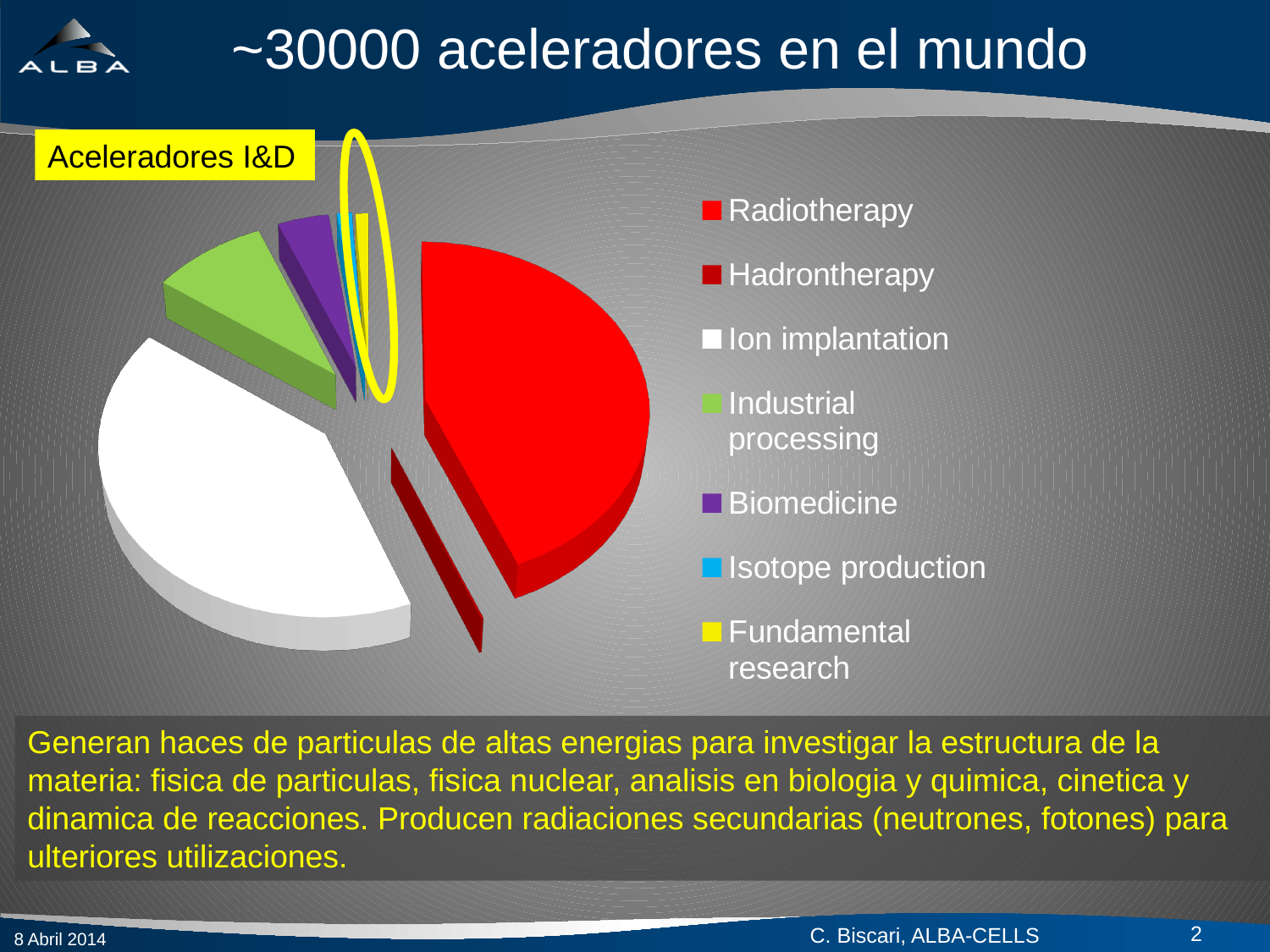
What colour is the Radiotherapy slice in the pie chart? red What kind of chart is shown on the slide? pie chart Which is larger in the pie chart, the slice for Radiotherapy or the slice for Hadrontherapy? Radiotherapy What is the title of the slide containing the pie chart? ~30000 aceleradores en el mundo Which is larger in the pie chart, the slice for Ion implantation or the slice for Fundamental research? Ion implantation Which is larger in the pie chart, the slice for Industrial processing or the slice for Biomedicine? Industrial processing Which legend entry of the pie chart is shown in yellow? Fundamental research How many categories does the pie chart's legend list? 7